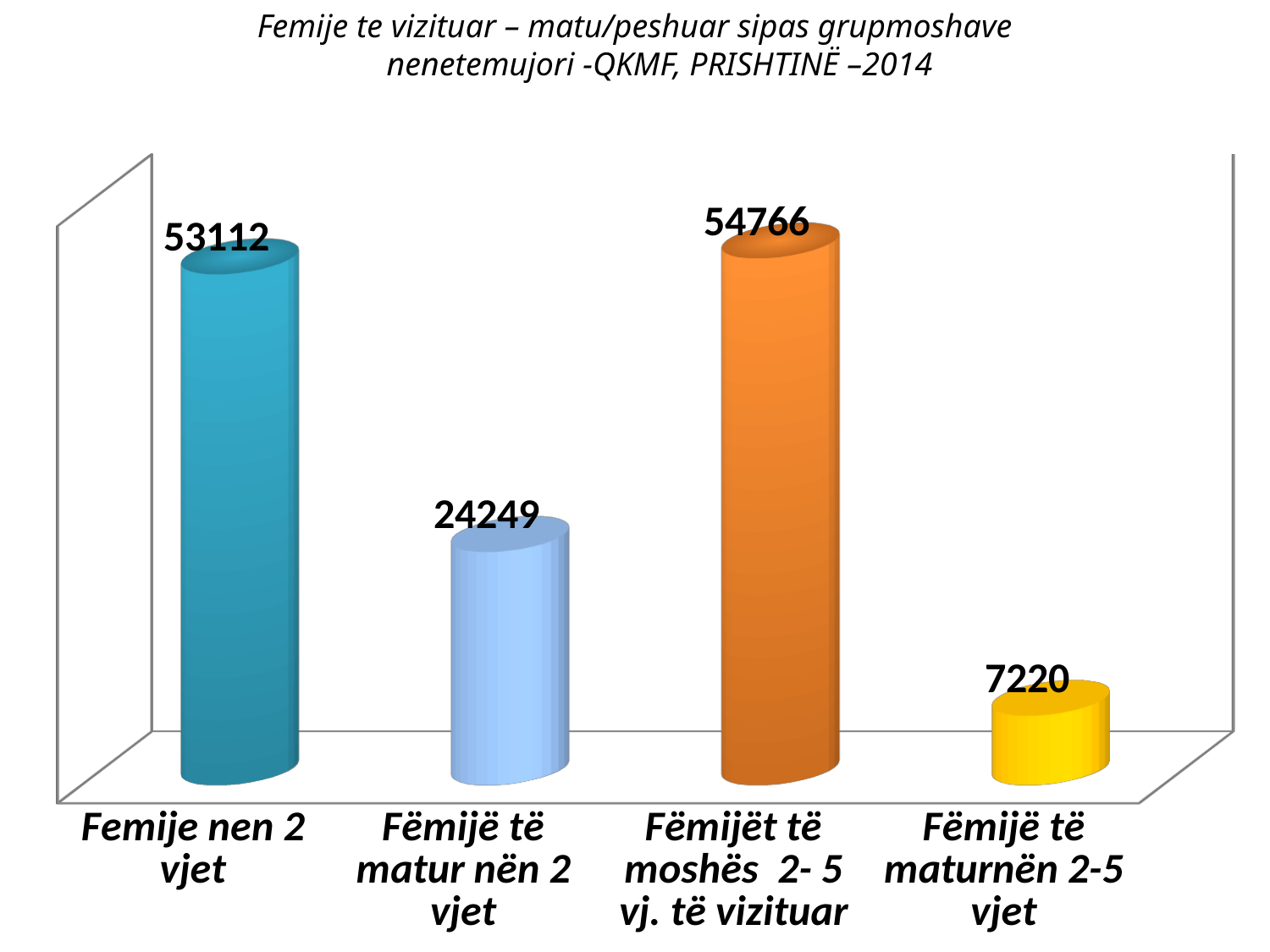
What is the value for "Fëmijët të moshës 2- 5 vj. të vizituar"? 54766 What is the difference between the values for "Fëmijët të moshës 2- 5 vj. të vizituar" and "Fëmijë të maturnën 2-5 vjet"? 47546 What is the value for "Fëmijë të matur nën 2 vjet"? 24249 What year is mentioned in the chart title? 2014 Which category has the highest value? Fëmijët të moshës 2- 5 vj. të vizituar How many categories are shown in the chart? 4 What kind of chart is shown on the slide? Bar chart Which is larger: the value for "Femije nen 2 vjet" or the value for "Fëmijët të moshës 2- 5 vj. të vizituar"? Fëmijët të moshës 2- 5 vj. të vizituar What is the value for "Fëmijë të maturnën 2-5 vjet"? 7220 What is the value for "Femije nen 2 vjet"? 53112 What is the difference between the values for "Femije nen 2 vjet" and "Fëmijë të matur nën 2 vjet"? 28863 Which category has the lowest value? Fëmijë të maturnën 2-5 vjet